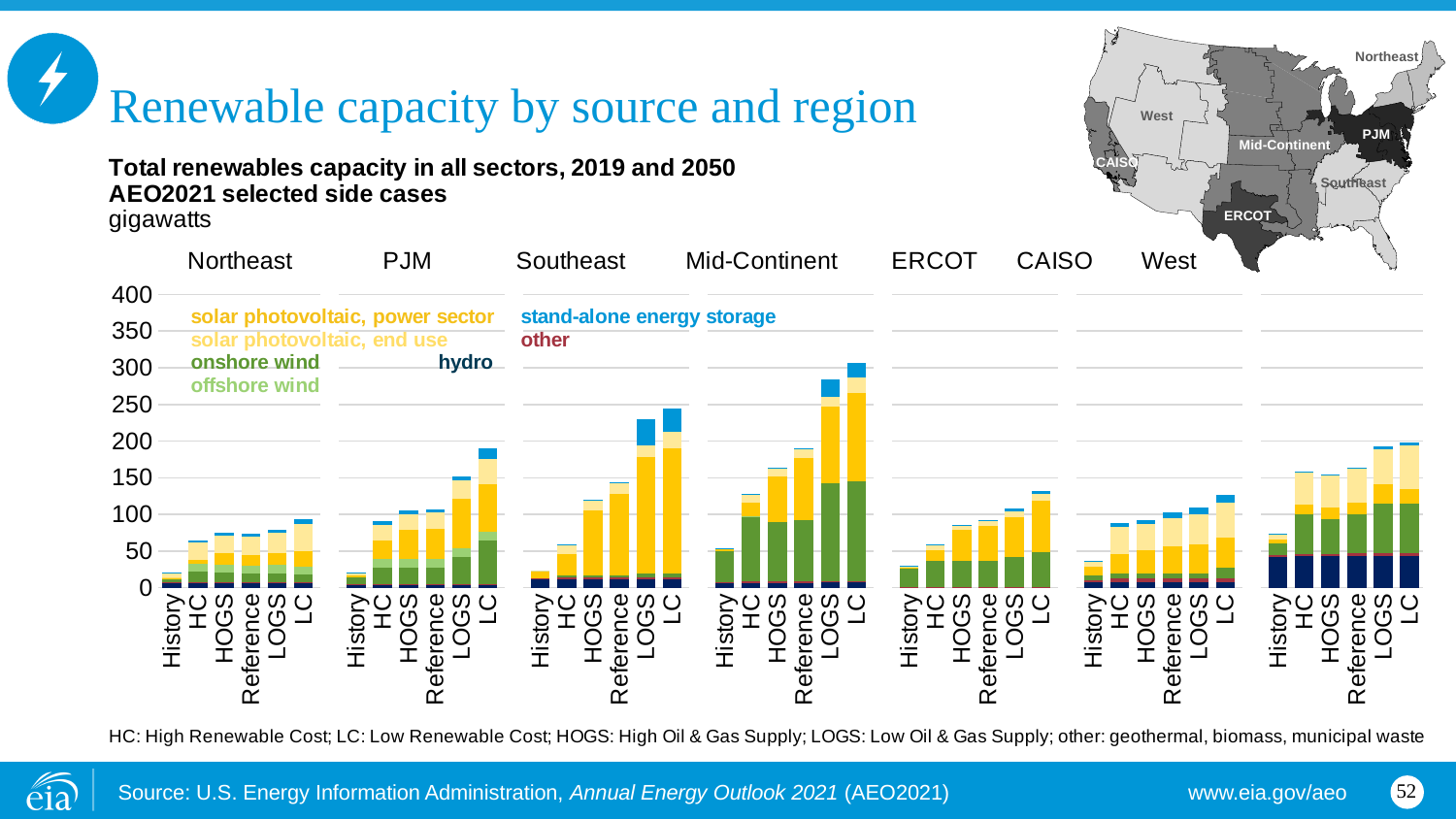
How many bars (cases) are plotted in the Northeast panel? 6 What kind of chart is shown on the slide? stacked bar chart Is the total for the ERCOT History case greater or less than 50? less Which is larger, the LC bar for PJM or the LC bar for the Northeast? PJM What unit are the values on the chart measured in? gigawatts Which region's LC bar is the tallest on the chart? Mid-Continent In the Northeast panel, which case has the lowest total renewable capacity? History Is the total for the West LC case greater or less than 150? greater In the Mid-Continent panel, do the bar totals generally rise or fall from History to LC? rise How many series does the chart's legend list? 7 Is the total for the Mid-Continent LC case greater or less than 250? greater How many regional panels does the chart contain? 7